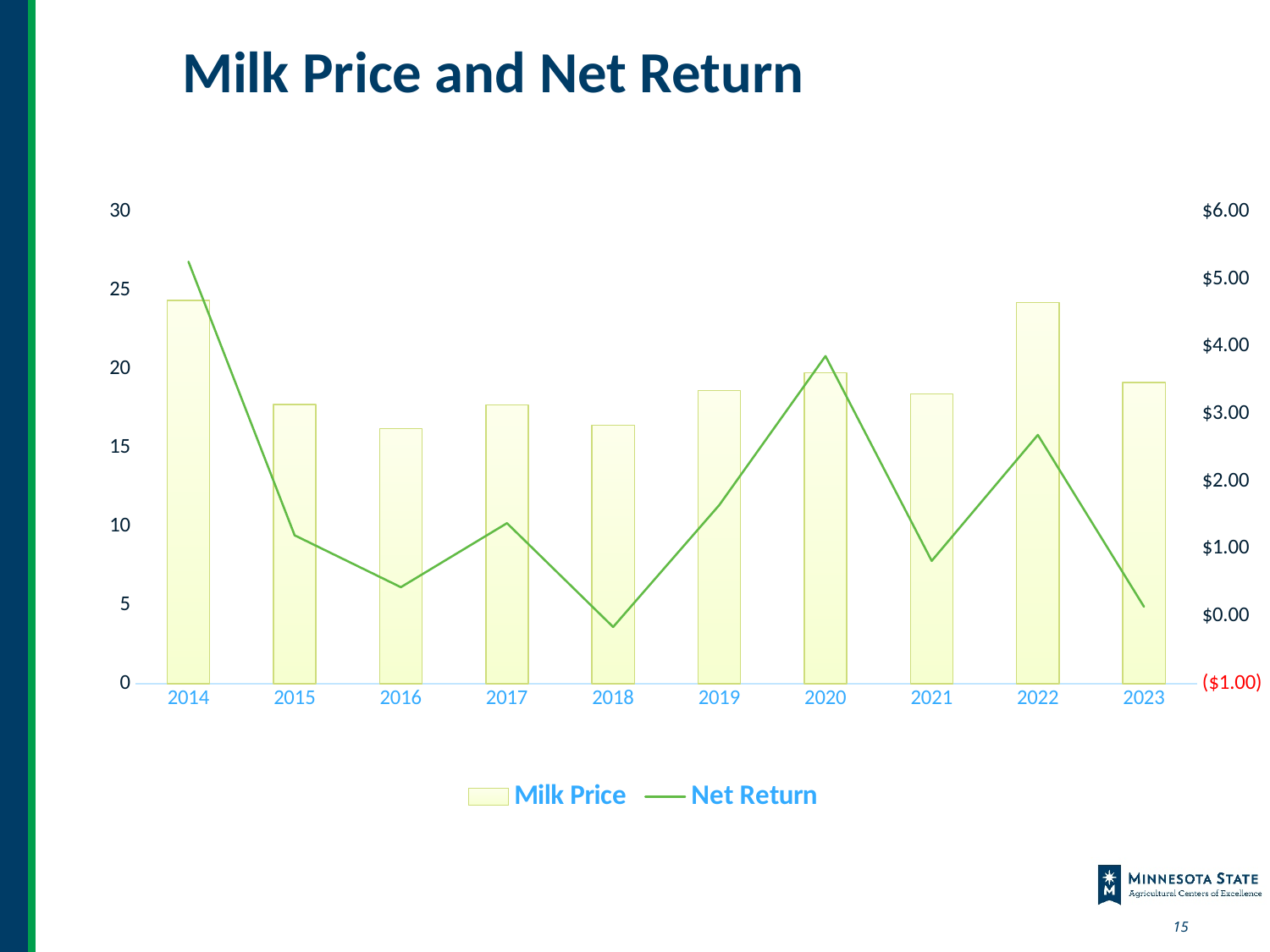
Is the Net Return value for 2020 greater or less than $3.00? greater Is the Milk Price value for 2014 greater or less than 20? greater What is the title of the chart? Milk Price and Net Return In which year is Net Return lowest? 2018 Does Net Return rise or fall from 2014 to 2018? fall What kind of chart is this? Combination bar and line chart How many years are shown on the x axis? 10 How many series does the legend list? 2 In which year is Net Return highest? 2014 Which year has the larger Milk Price, 2014 or 2015? 2014 Is the Milk Price value for 2016 greater or less than 20? less Which series is drawn as a line? Net Return